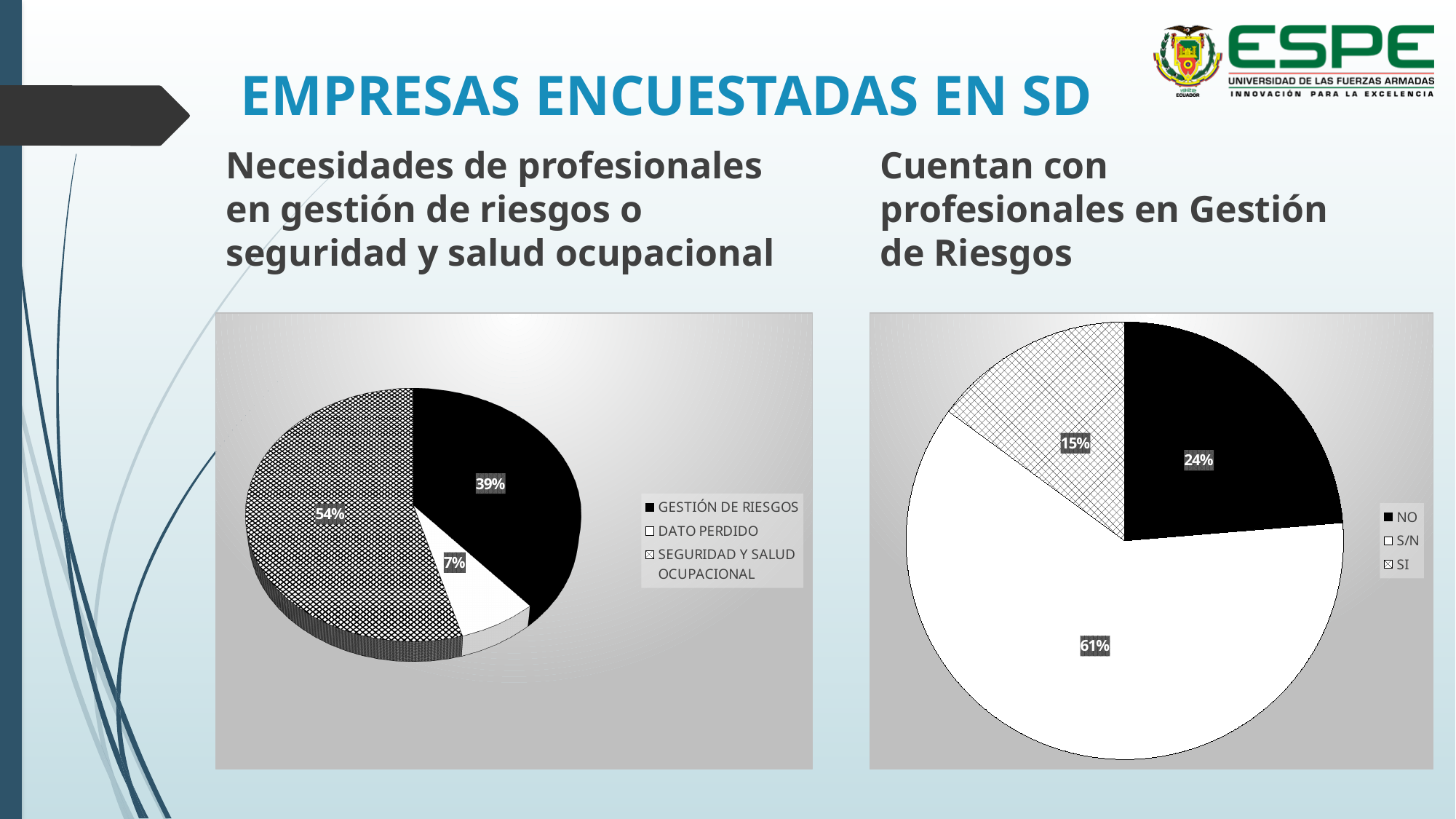
In the right chart (Cuentan con profesionales en Gestión de Riesgos), what share is labelled for NO? 24% In the left chart (Necesidades de profesionales), what share is labelled for DATO PERDIDO? 7% In the left chart (Necesidades de profesionales), what share is labelled for SEGURIDAD Y SALUD OCUPACIONAL? 54% In the right chart (Cuentan con profesionales en Gestión de Riesgos), what share is labelled for SI? 15% In the left chart (Necesidades de profesionales), which category has the largest slice? SEGURIDAD Y SALUD OCUPACIONAL In the left chart (Necesidades de profesionales), what share is labelled for GESTIÓN DE RIESGOS? 39% How many categories does the legend of the right chart (Cuentan con profesionales en Gestión de Riesgos) list? 3 In the right chart (Cuentan con profesionales en Gestión de Riesgos), which category has the largest slice? S/N In the right chart (Cuentan con profesionales en Gestión de Riesgos), which is larger, NO or SI? NO In the left chart (Necesidades de profesionales), which category has the smallest slice? DATO PERDIDO In the left chart (Necesidades de profesionales), what is the difference in percentage points between SEGURIDAD Y SALUD OCUPACIONAL and GESTIÓN DE RIESGOS? 15 percentage points What kind of chart is the left chart (Necesidades de profesionales)? Pie chart